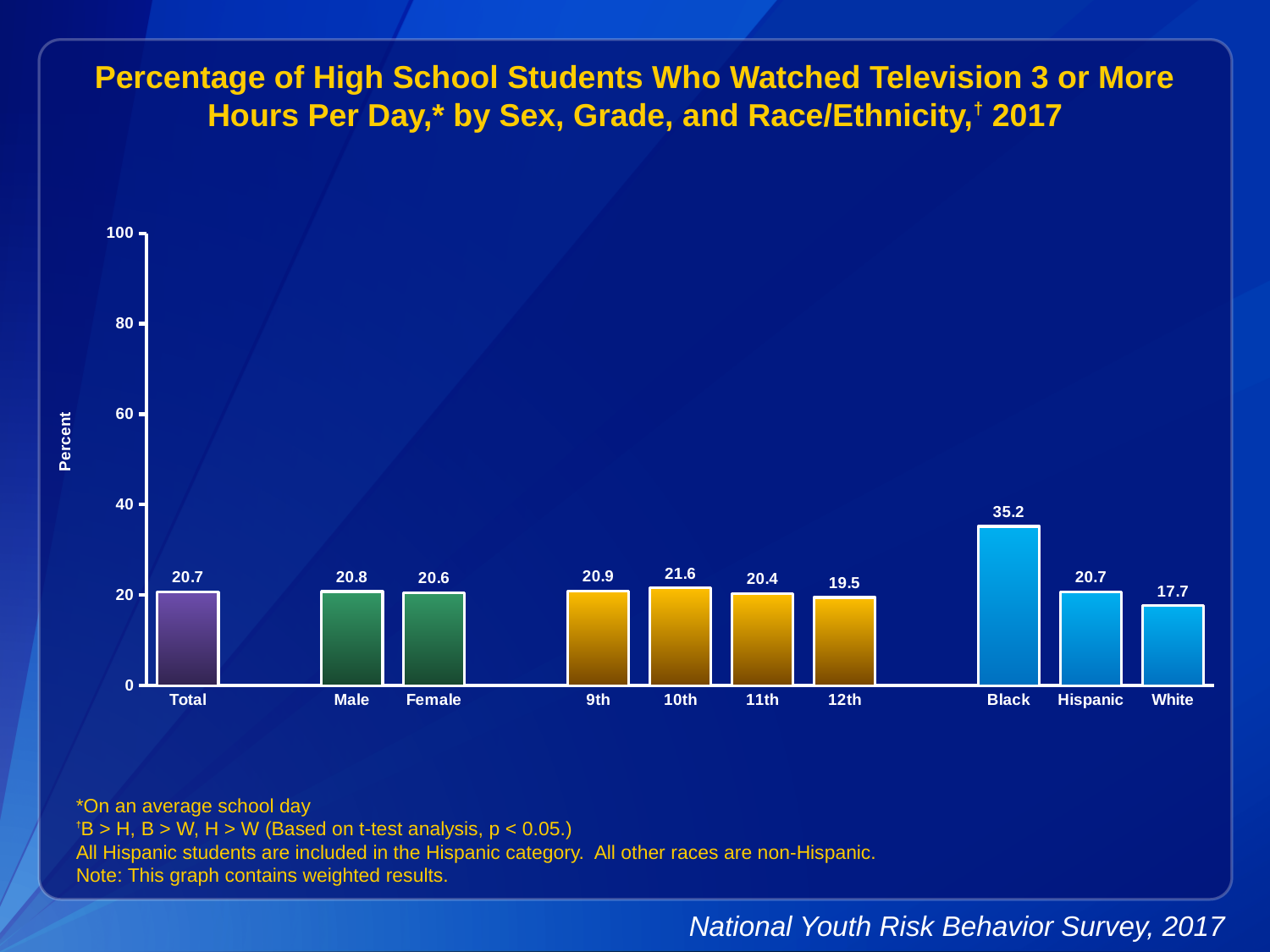
What is the label of the y axis? Percent What is the value for Black students? 35.2 Which category has the lowest value? White What is the value for the Total category? 20.7 Is the value for Black students greater or less than 40? less What is the value for 12th grade students? 19.5 What kind of chart is shown on the slide? bar chart What is the difference between the values for Black and White students? 17.5 Which is larger, the value for Black students or the value for Hispanic students? Black How many categories are shown on the x axis? 10 What is the difference between the values for 10th and 12th grade students? 2.1 Which category has the highest value? Black